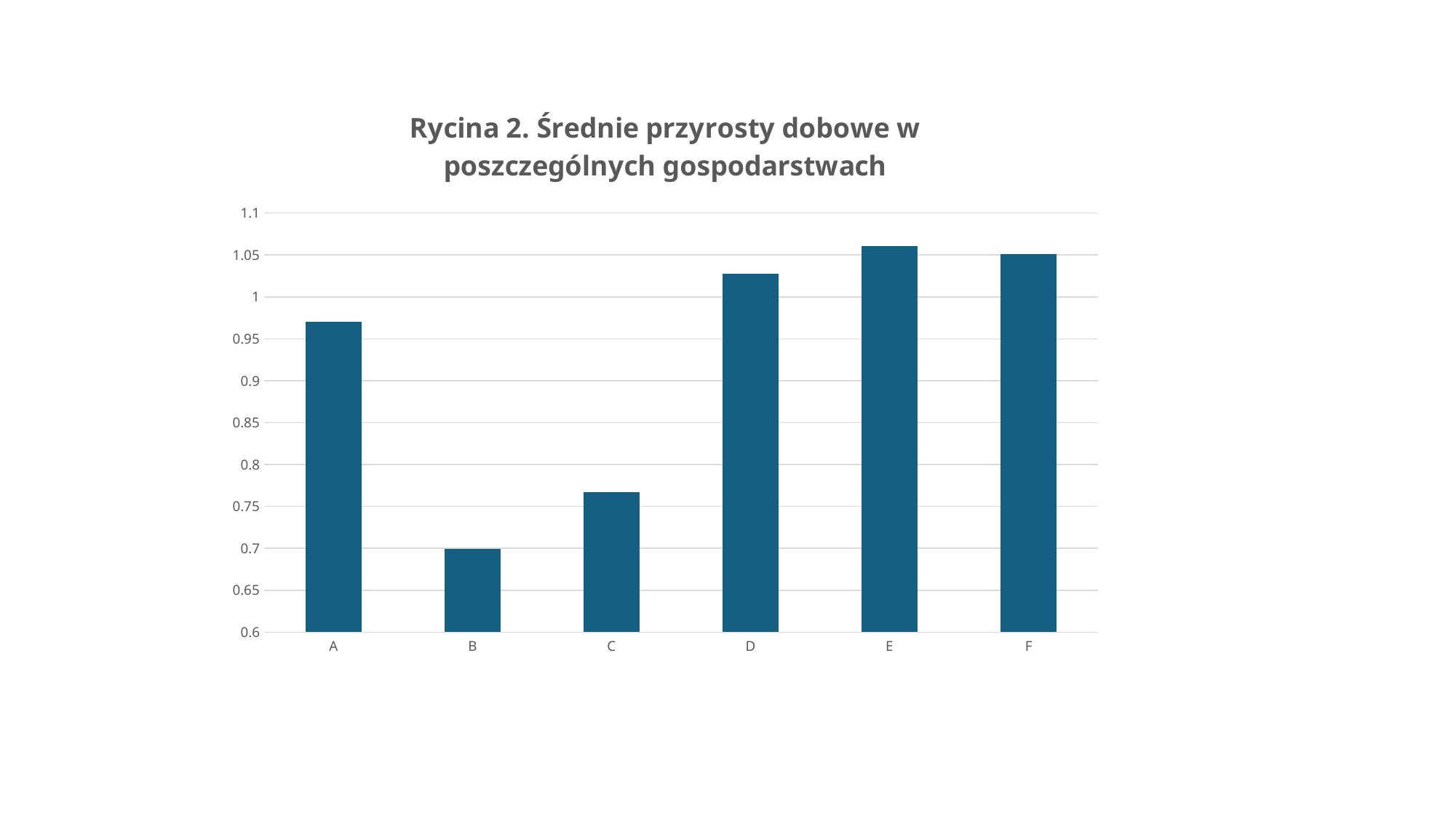
How many categories are shown on the x axis of the chart? 6 Is the value for B greater or less than 0.75? less Which is larger, the value for B or the value for C? C Is the value for E greater or less than 1? greater What kind of chart is shown on the slide? bar chart Which is larger, the value for A or the value for D? D Is the value for A greater or less than 1? less What is the title of the chart? Rycina 2. Średnie przyrosty dobowe w poszczególnych gospodarstwach Which is larger, the value for C or the value for A? A Which category has the lowest value in the chart? B